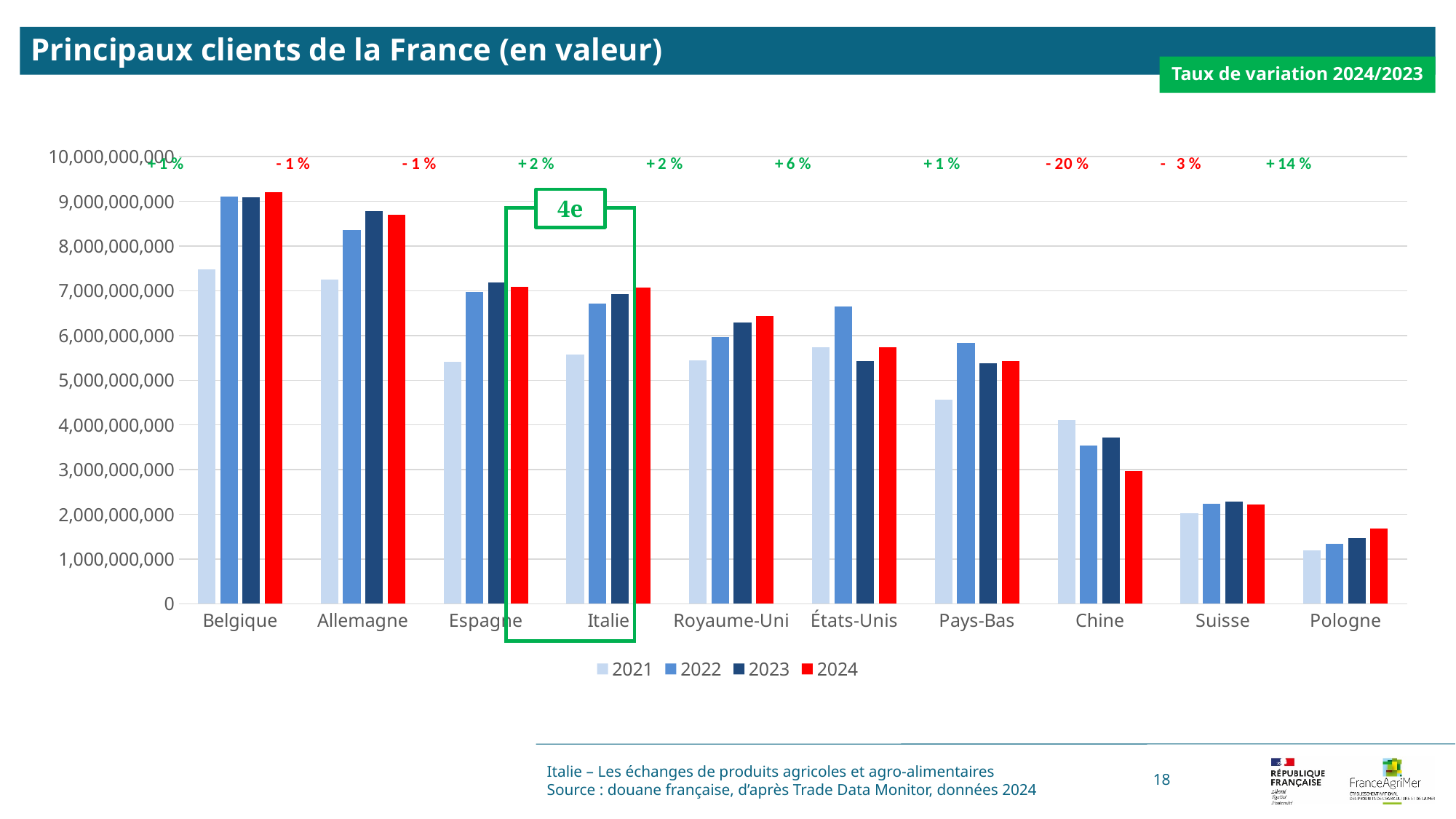
Is the 2024 value for Chine greater or less than 4,000,000,000? less What is the 2024/2023 variation rate printed above États-Unis? + 6 % How many series does the legend list? 4 What is the 2024/2023 variation rate printed above Pologne? + 14 % Is the 2024 value for Belgique greater or less than 9,000,000,000? greater Which country has the highest 2024 value? Belgique Which is larger, the 2024 value for Belgique or the 2024 value for Allemagne? Belgique How many countries are shown on the x axis of the chart? 10 What kind of chart is shown on the slide? bar chart Which country has the lowest 2024 value? Pologne Which country is marked with the green "4e" box on the chart? Italie What is the 2024/2023 variation rate printed above Chine? - 20 %